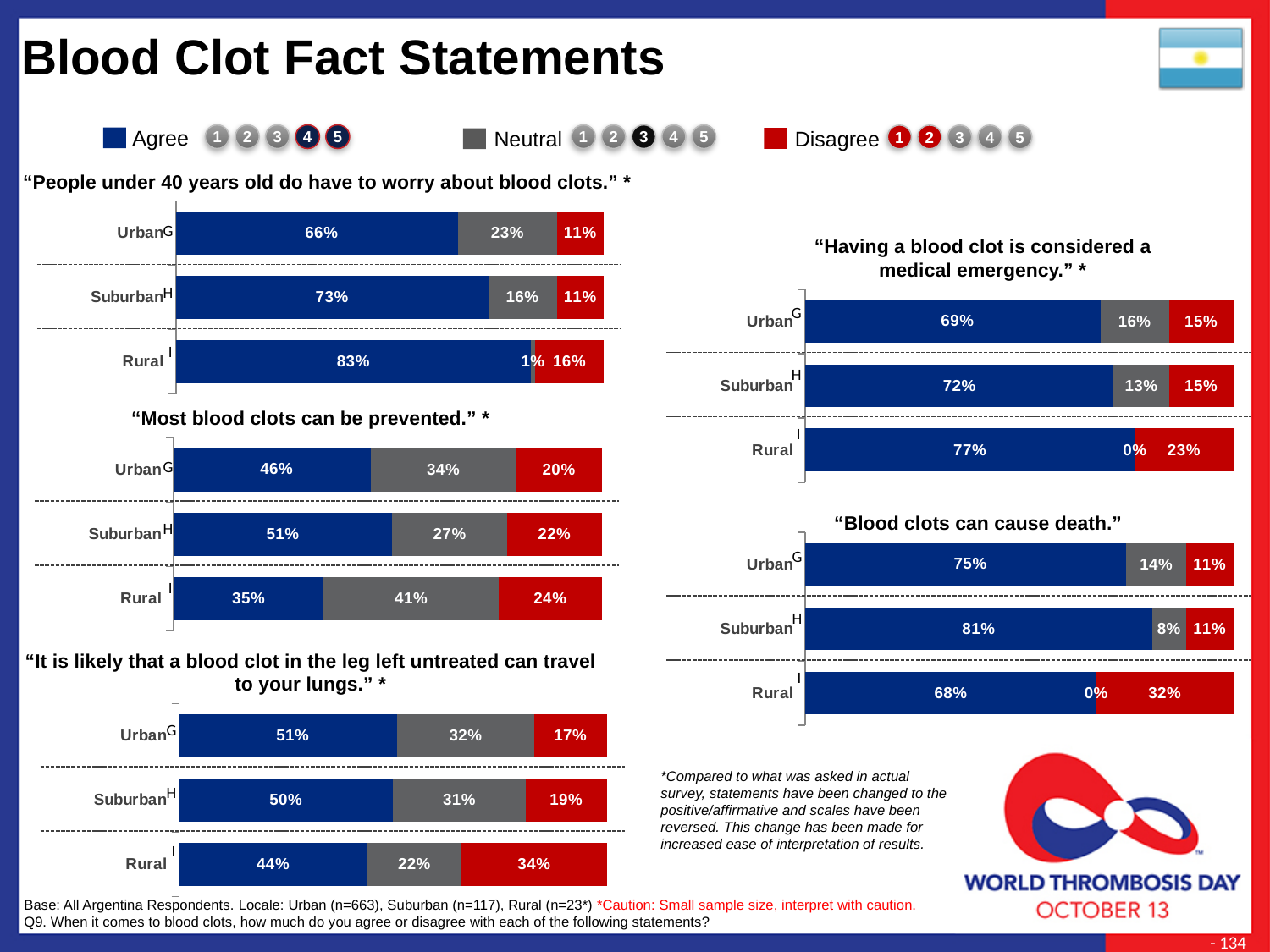
Which colour represents the Disagree series in the legend? Red In the chart "Most blood clots can be prevented.", what is the Neutral percentage for Rural respondents? 41% In the chart "Having a blood clot is considered a medical emergency.", which locale has the highest Agree percentage? Rural In the chart "Most blood clots can be prevented.", which locale has the lowest Agree percentage? Rural In the chart "It is likely that a blood clot in the leg left untreated can travel to your lungs.", what is the difference between the Disagree percentages for Rural and Urban? 17% In the chart "People under 40 years old do have to worry about blood clots.", what percentage of Rural respondents agree? 83% How many locale categories are shown in the chart "Having a blood clot is considered a medical emergency."? 3 What type of chart is used for "Most blood clots can be prevented."? Stacked bar chart In the chart "Blood clots can cause death.", which locale has a higher Agree percentage, Urban or Suburban? Suburban In the chart "Blood clots can cause death.", what percentage of Rural respondents disagree? 32% How many series does the legend at the top of the slide list? 3 In the chart "People under 40 years old do have to worry about blood clots.", what is the total of the Suburban bar (Agree + Neutral + Disagree)? 100%